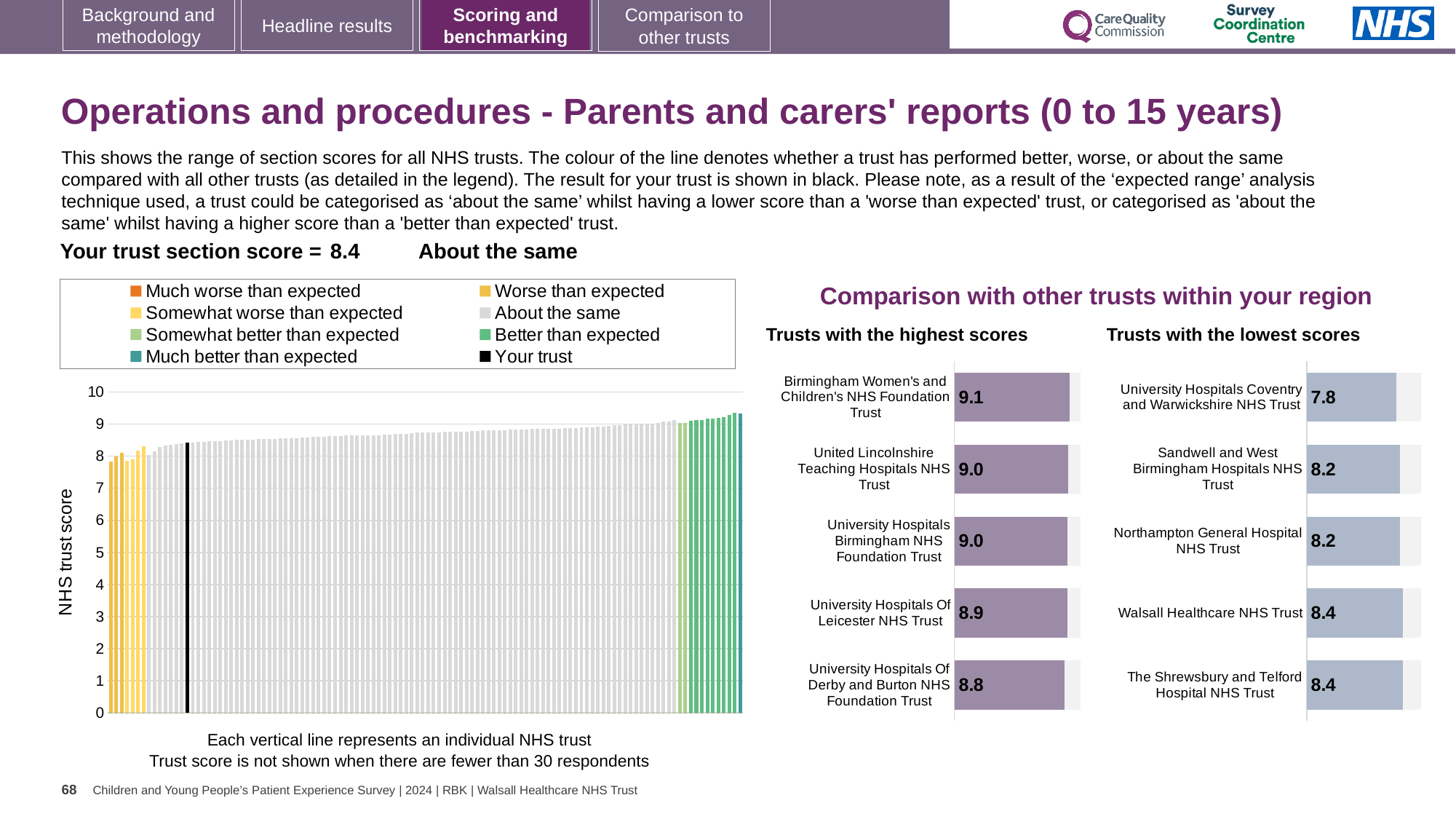
How many entries does the legend of the large chart on the left list? 8 In the 'Trusts with the lowest scores' chart, which has the higher score: Sandwell and West Birmingham Hospitals NHS Trust or Walsall Healthcare NHS Trust? Walsall Healthcare NHS Trust In the 'Trusts with the lowest scores' chart, what is the score for University Hospitals Coventry and Warwickshire NHS Trust? 7.8 In the 'Trusts with the highest scores' chart, which trust has the highest score? Birmingham Women's and Children's NHS Foundation Trust In the 'Trusts with the lowest scores' chart, which trust has the lowest score? University Hospitals Coventry and Warwickshire NHS Trust In the 'Trusts with the highest scores' chart, what is the score for Birmingham Women's and Children's NHS Foundation Trust? 9.1 In the 'Trusts with the lowest scores' chart, what is the difference between the scores of Walsall Healthcare NHS Trust and University Hospitals Coventry and Warwickshire NHS Trust? 0.6 In the 'Trusts with the highest scores' chart, what is the difference between the scores of Birmingham Women's and Children's NHS Foundation Trust and University Hospitals Of Derby and Burton NHS Foundation Trust? 0.3 In the large chart on the left, is the value of the leftmost (lowest) bar greater or less than 8? less How many trusts are shown in the 'Trusts with the highest scores' chart? 5 What is the section score for your trust shown on the slide? 8.4 What kind of chart is the large chart on the left showing NHS trust scores? Bar chart